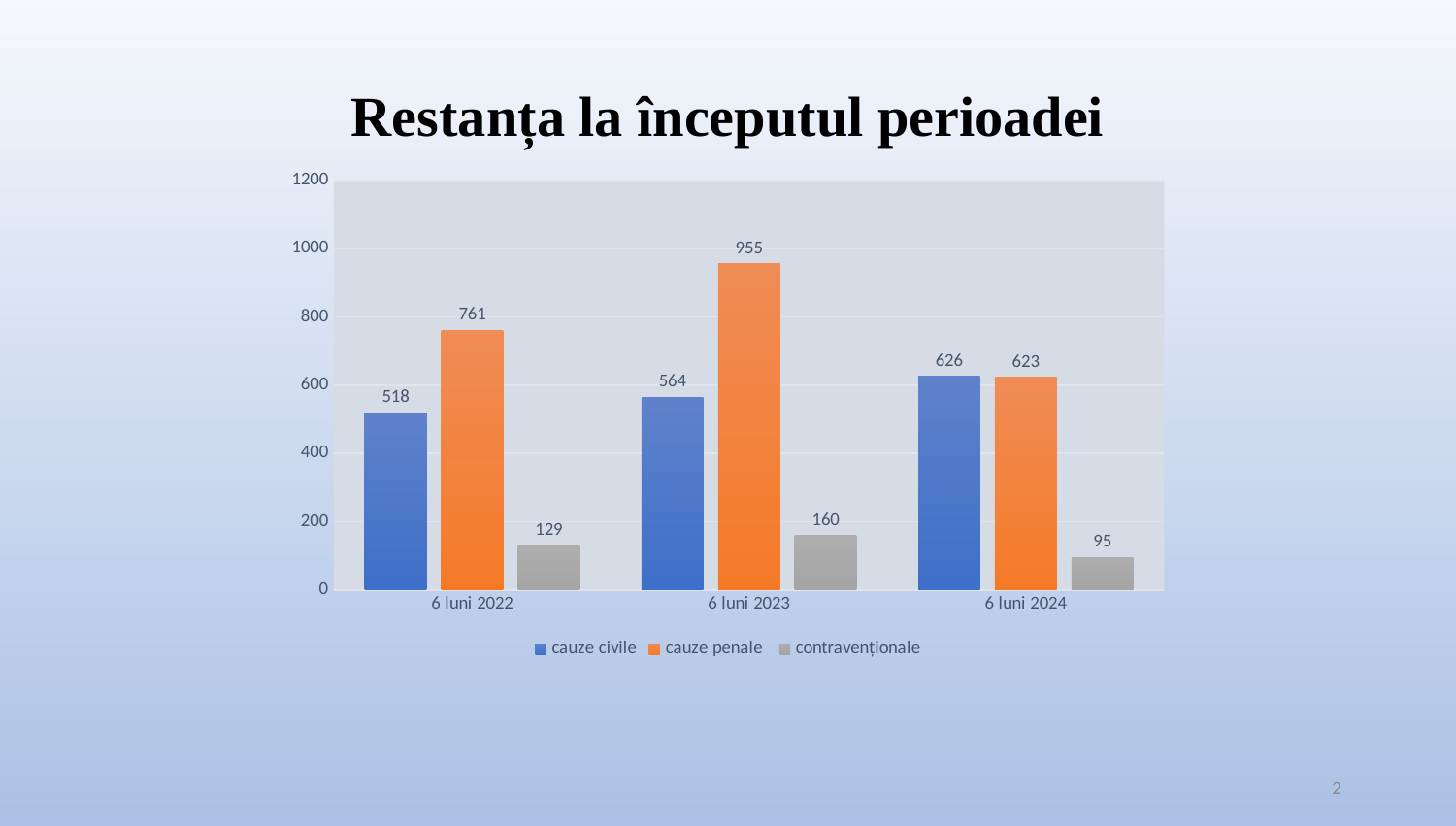
What is the difference between cauze penale and cauze civile in 6 luni 2022? 243 Is the value for cauze civile in 6 luni 2024 greater or less than 600? greater Do the values for cauze civile rise or fall from 6 luni 2022 to 6 luni 2024? rise How many series does the legend list? 3 What is the value for cauze penale in 6 luni 2023? 955 What kind of chart is shown on the slide? bar chart How many periods are shown on the x axis? 3 Which period has the lowest value for contravenționale? 6 luni 2024 What is the value for cauze civile in 6 luni 2022? 518 What is the value for contravenționale in 6 luni 2024? 95 Which period has the highest value for cauze penale? 6 luni 2023 Which is larger in 6 luni 2023: cauze civile or cauze penale? cauze penale